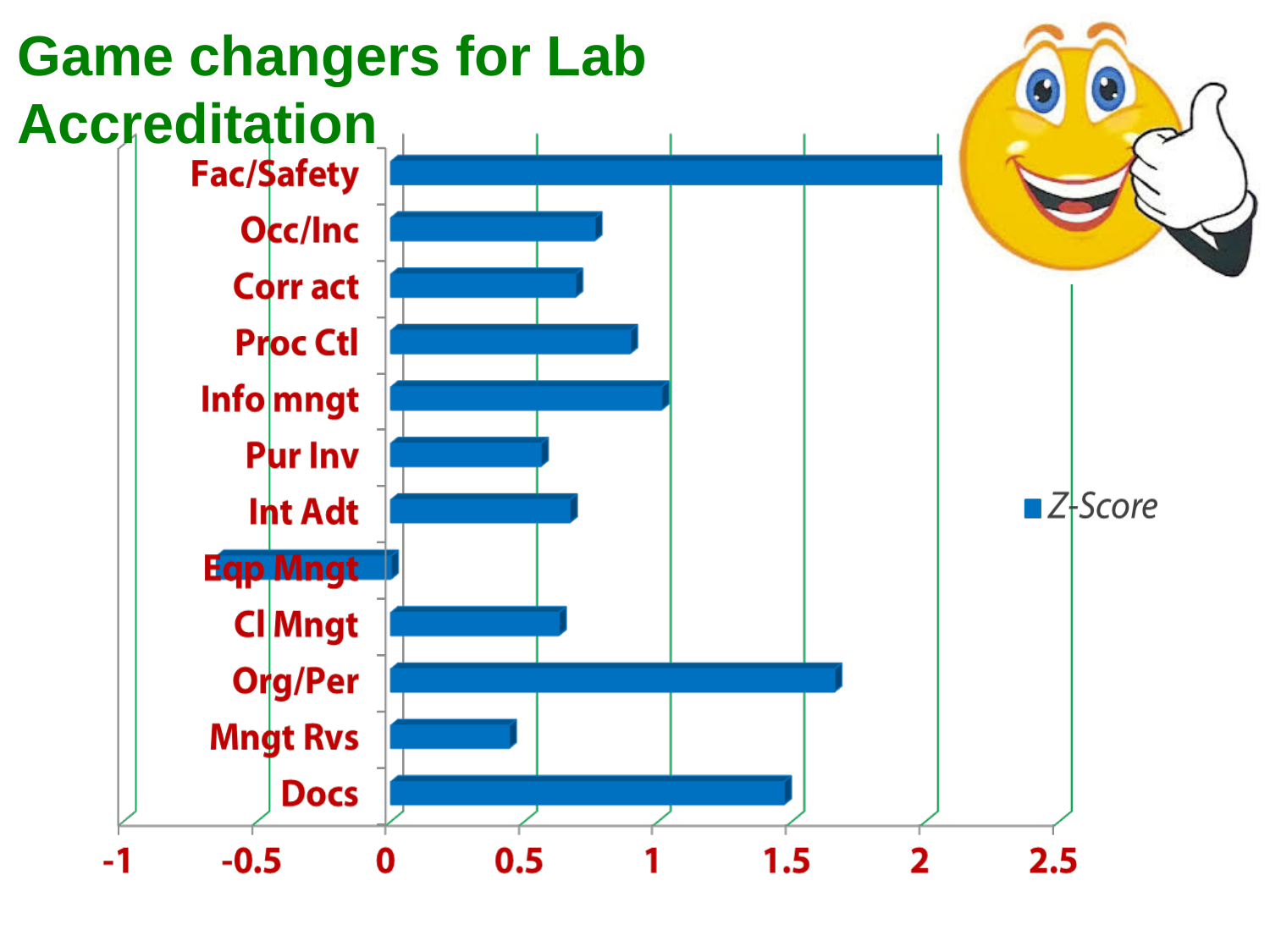
Which has a larger Z-Score, Org/Per or Docs? Org/Per Is the Z-Score for Fac/Safety greater or less than 2? greater How many series does the legend list? 1 Which category has the highest Z-Score? Fac/Safety Is the Z-Score for Eqp Mngt greater or less than 0? less How many categories are plotted on the chart? 12 Which has a larger Z-Score, Occ/Inc or Mngt Rvs? Occ/Inc Is the Z-Score for Org/Per greater or less than 1.5? greater What kind of chart is shown on the slide? bar chart What is the name of the series shown in the legend? Z-Score Which category has the lowest Z-Score? Eqp Mngt